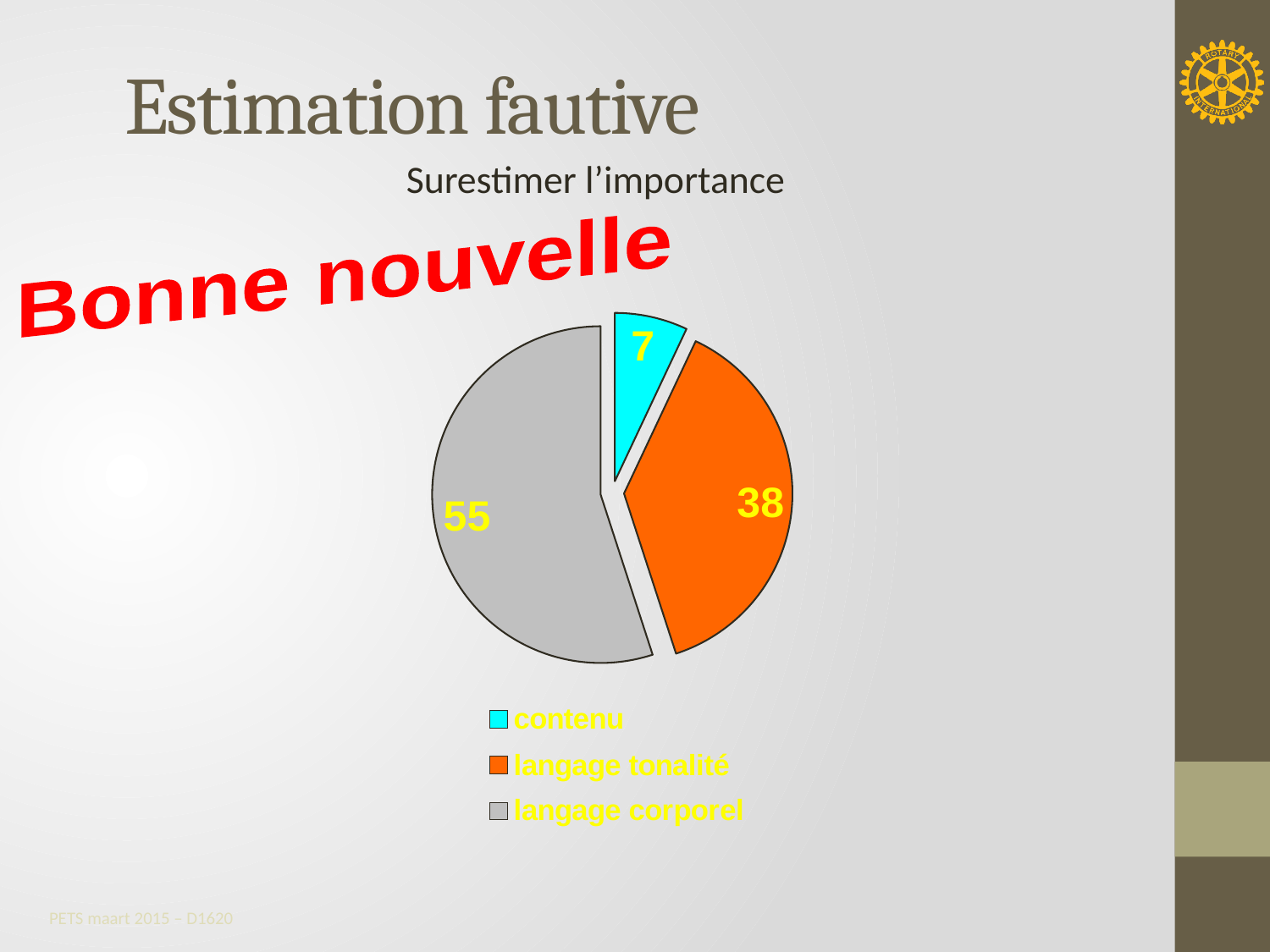
Which category has the largest slice? langage corporel What is the value for contenu? 7 What colour is the slice for langage tonalité? orange How many entries does the legend list? 3 What is the value for langage corporel? 55 Which is larger, langage tonalité or contenu? langage tonalité What is the value for langage tonalité? 38 What type of chart is shown on the slide? pie chart What is the difference between the values for langage corporel and langage tonalité? 17 What is the difference between the values for langage tonalité and contenu? 31 Which category has the smallest slice? contenu How many slices does the pie chart have? 3